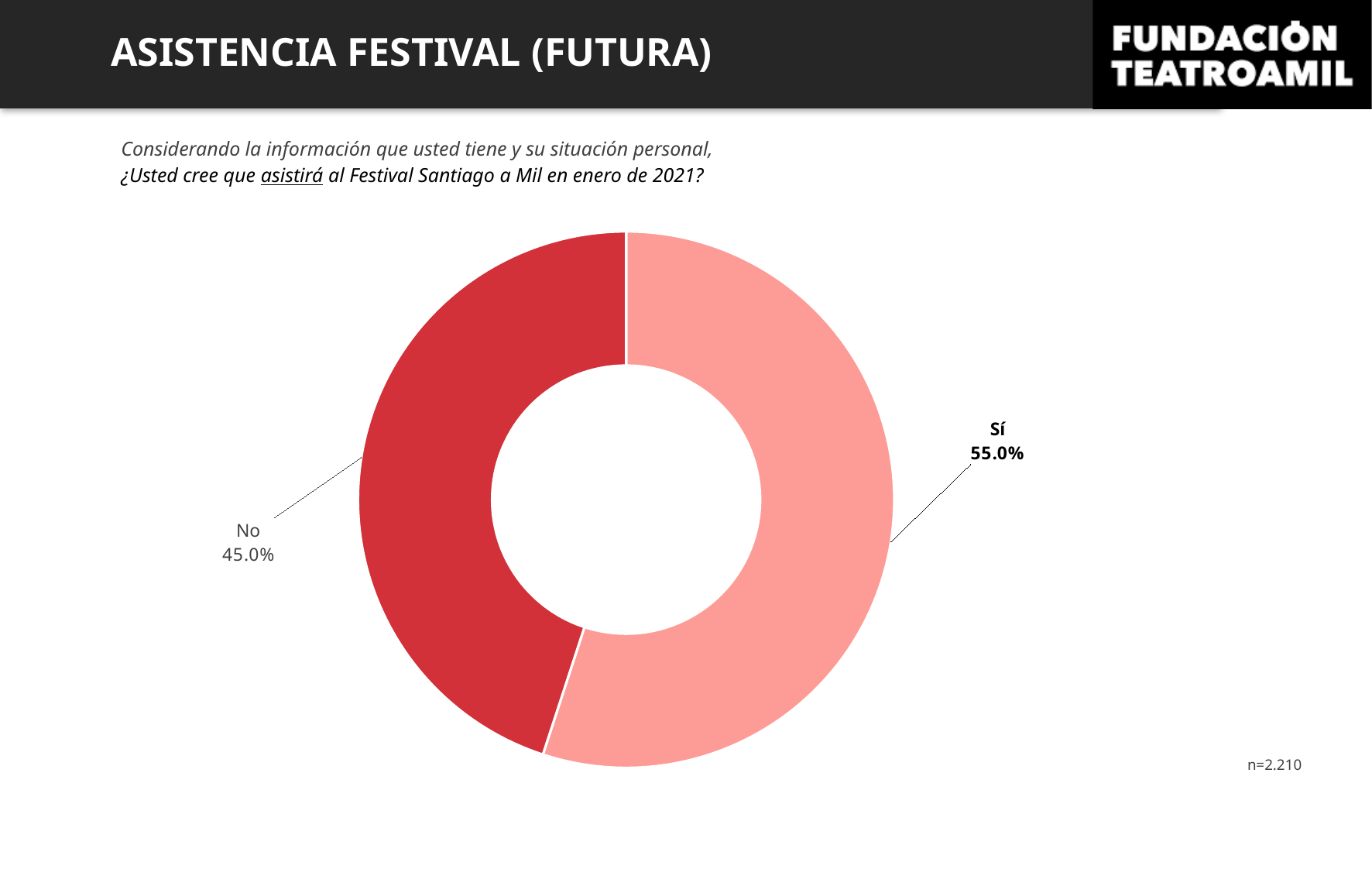
How many categories are shown in the chart? 2 What percentage of respondents answered "Sí"? 55.0% What kind of chart is shown on the slide? Doughnut (pie) chart What is the title of the slide? ASISTENCIA FESTIVAL (FUTURA) Which response has the smaller share of the chart? No What is the difference in percentage points between the "Sí" and "No" shares? 10.0 percentage points Is the share for "Sí" larger or smaller than the share for "No"? larger What is the sample size (n) shown on the slide? n=2.210 What share of the chart does the "No" slice represent? 45.0% Which response has the larger share of the chart? Sí What percentage of respondents answered "No"? 45.0%